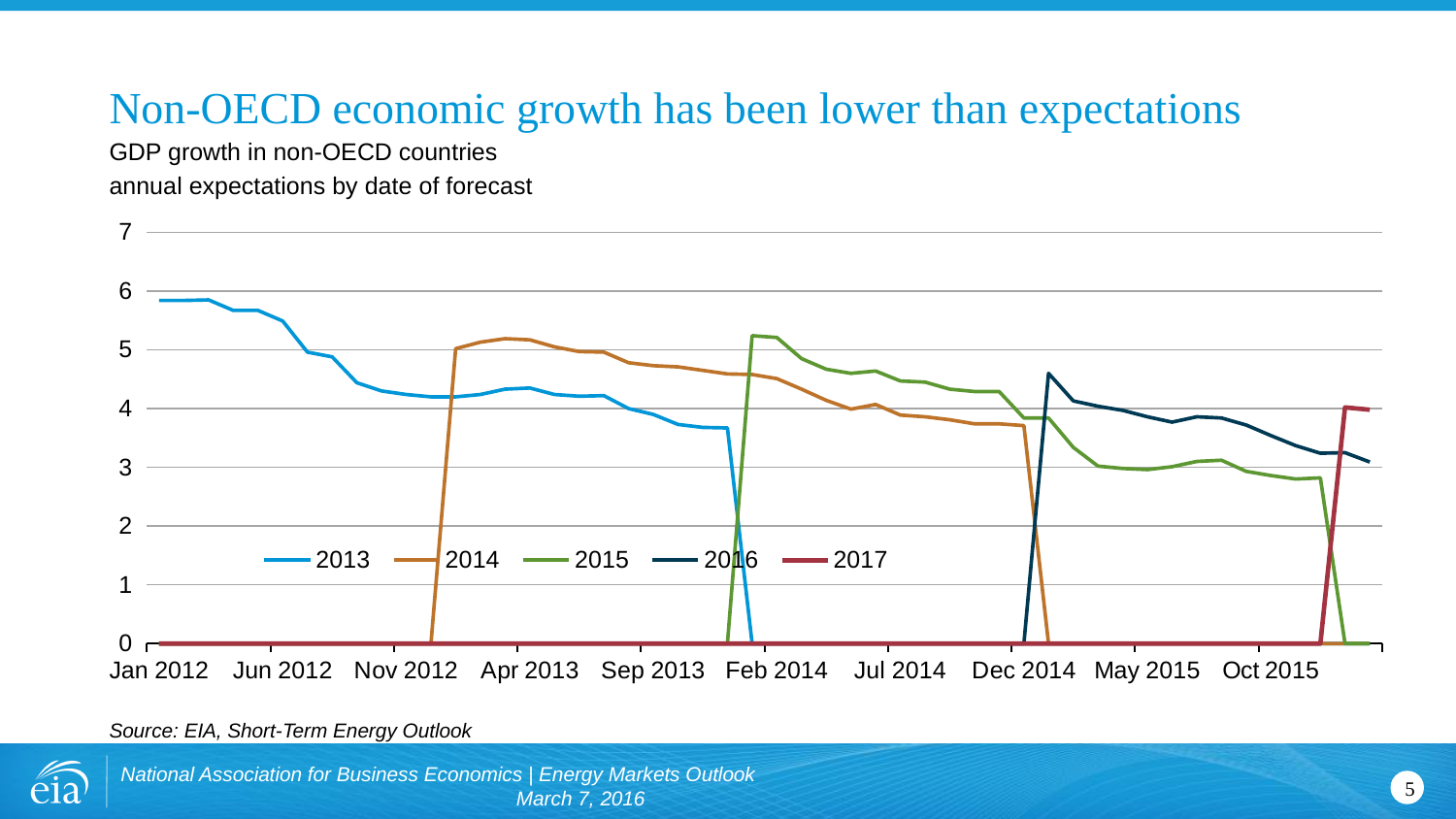
Does the 2016 series rise or fall between Dec 2014 and the end of the chart? fall What is the title of the slide? Non-OECD economic growth has been lower than expectations Does the 2014 series rise or fall between Apr 2013 and Dec 2014? fall How many series does the legend list? 5 Is the value of the 2013 series at Jan 2012 greater or less than 6? less What kind of chart is shown on the slide? line chart Which series reaches the highest value anywhere on the chart? 2013 Is the value of the 2015 series at Feb 2014 greater or less than 5? greater Which years are listed in the chart legend? 2013, 2014, 2015, 2016, 2017 Is the value of the 2013 series at Jan 2012 greater or less than 5? greater Does the 2013 series rise or fall between Jan 2012 and Feb 2014? fall